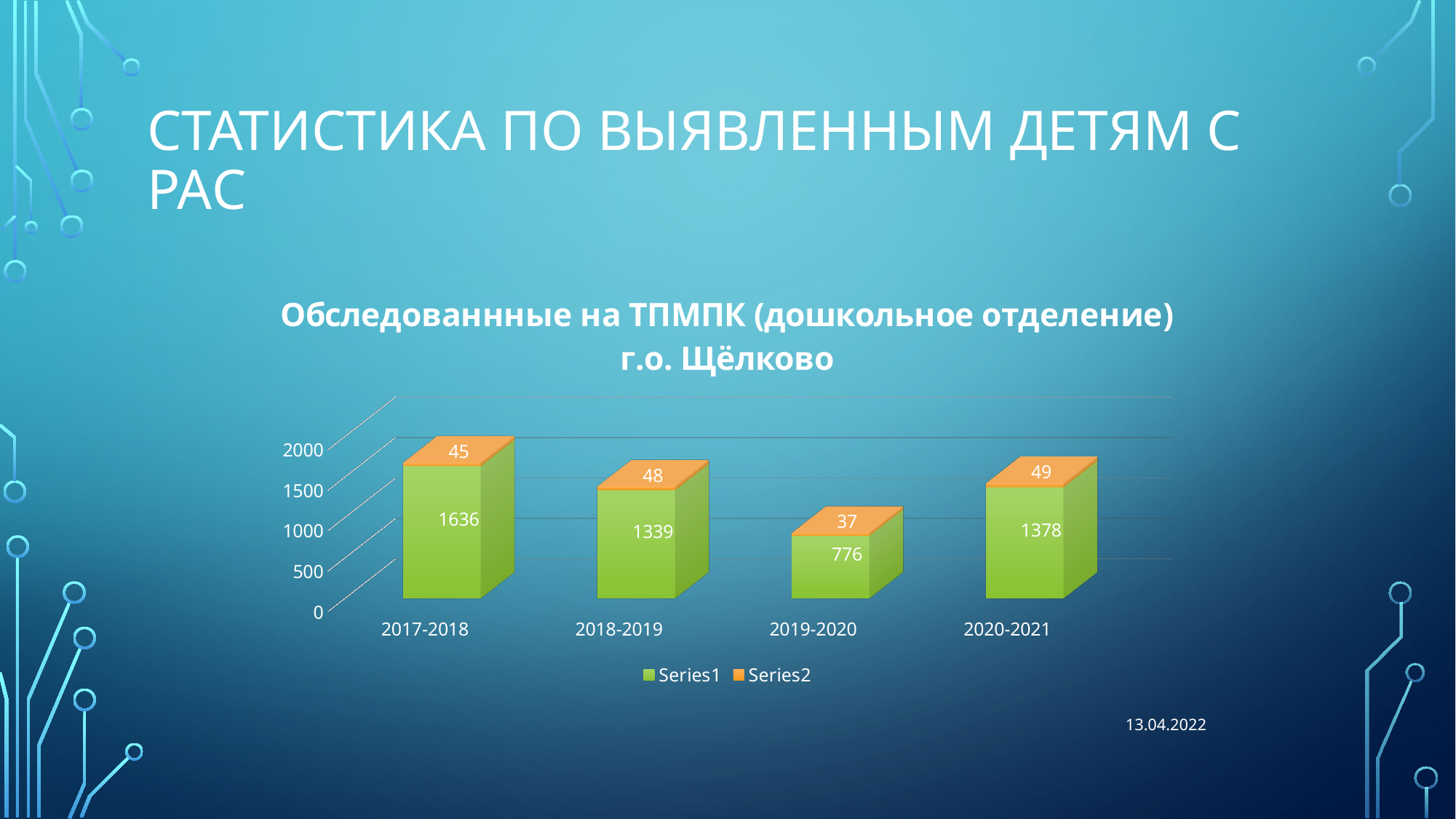
What kind of chart is shown on the slide? Stacked bar chart How many series does the legend list? 2 Which category has the lowest Series2 value? 2019-2020 Which category has the highest Series1 value? 2017-2018 What is the Series1 value for 2020-2021? 1378 How many categories are shown on the x axis? 4 What is the total of the stacked bar for 2017-2018? 1681 What is the Series2 value for 2019-2020? 37 Which is larger, the Series1 value for 2018-2019 or for 2020-2021? 2020-2021 What is the difference between the Series1 values for 2018-2019 and 2019-2020? 563 What is the Series1 value for 2017-2018? 1636 What colour represents Series2 in the chart? Orange